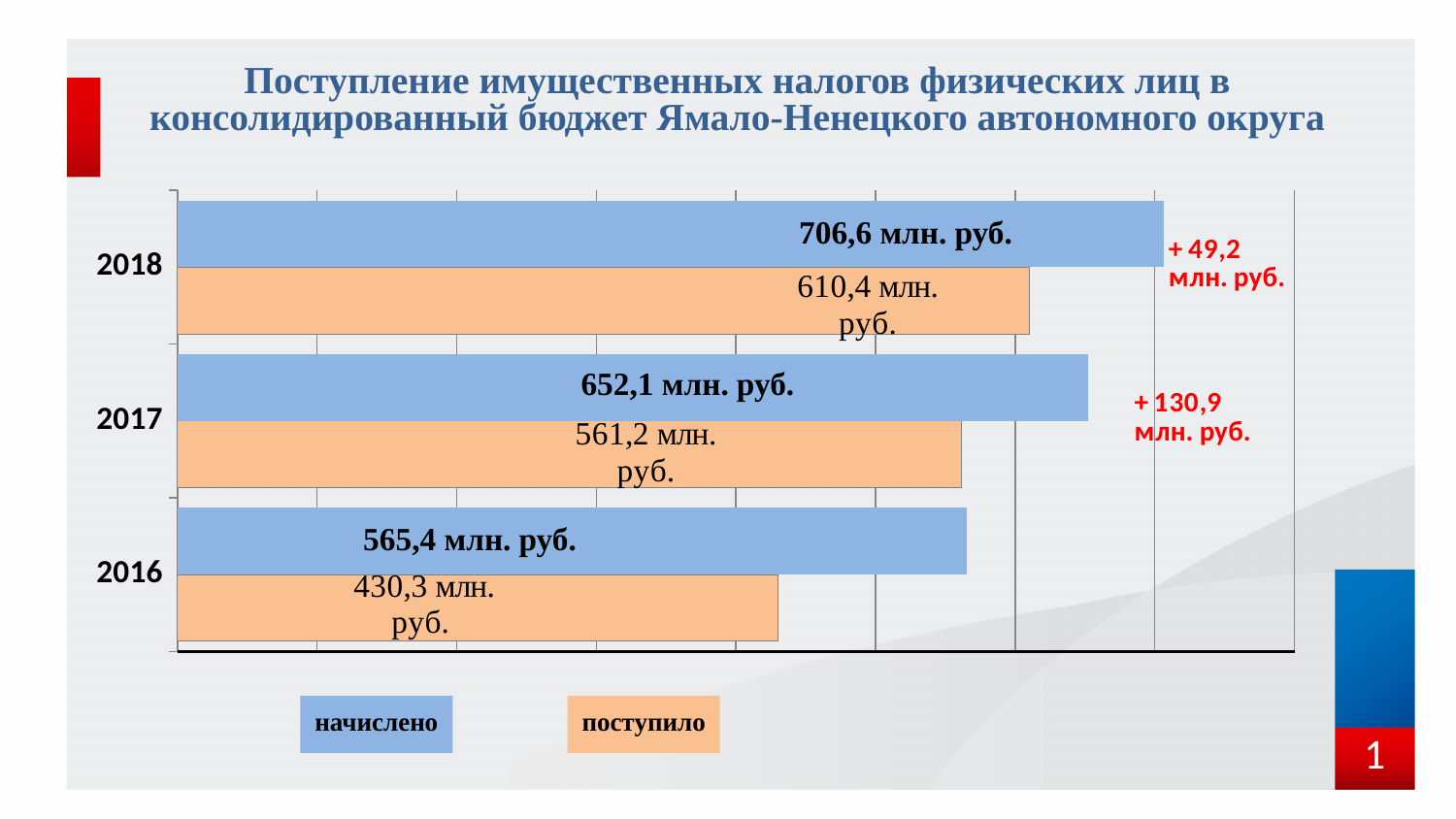
Do the 'поступило' values rise or fall from 2016 to 2018? rise How many series does the legend list? 2 What is the value of 'поступило' for 2016? 430,3 млн. руб. What type of chart is shown on the slide? bar chart By how much did 'поступило' increase from 2017 to 2018? 49,2 млн. руб. Which year has the highest 'начислено' value? 2018 How many years are shown on the chart? 3 What is the difference between 'начислено' and 'поступило' in 2016? 135,1 млн. руб. What is the value of 'поступило' for 2017? 561,2 млн. руб. Which year has the lowest 'поступило' value? 2016 What is the value of 'начислено' for 2018? 706,6 млн. руб. Which is larger in 2017: 'начислено' or 'поступило'? начислено